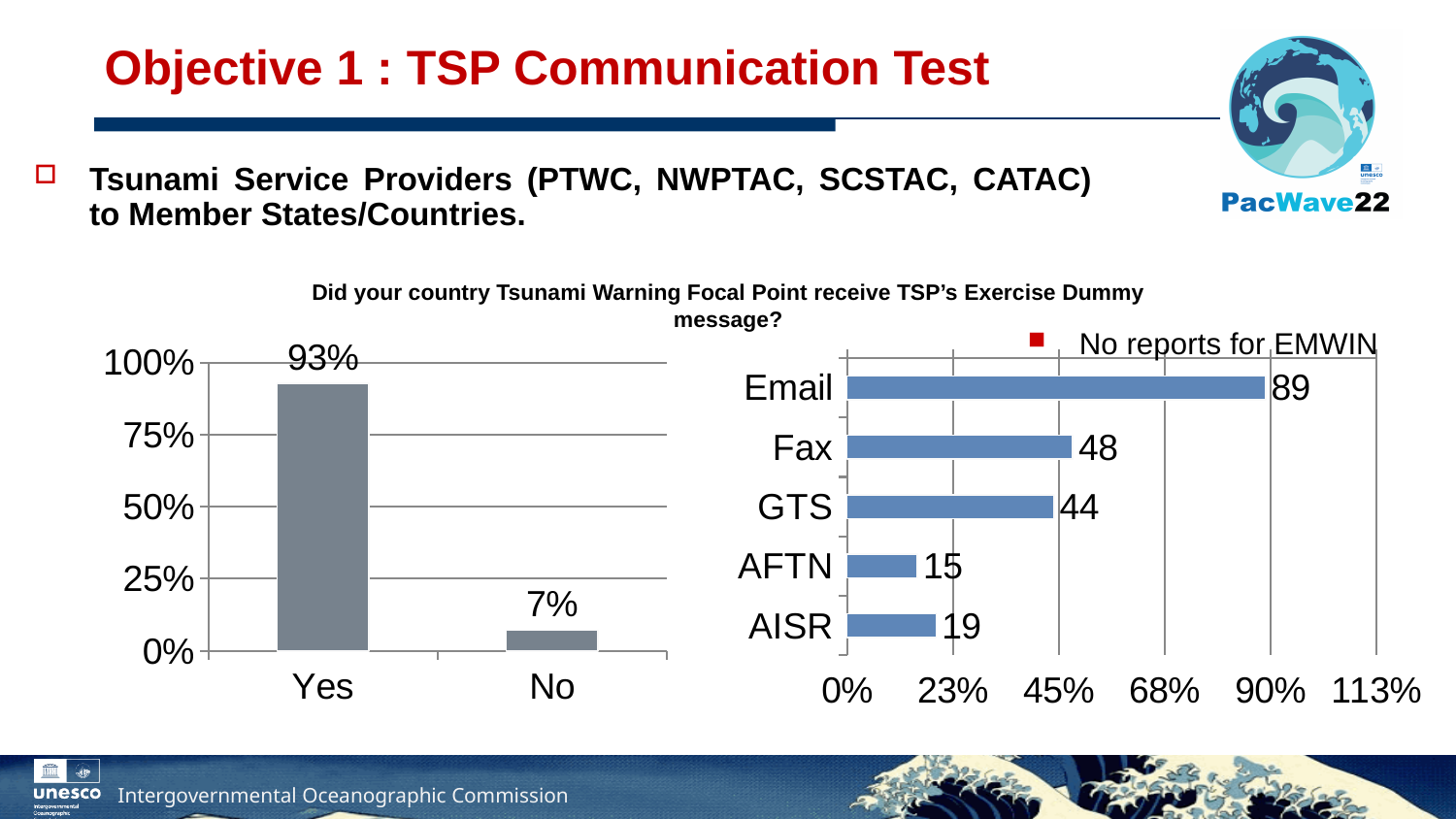
On the right chart, what is the value for Email? 89 On the left chart, what is the value for No? 7% What kind of chart is the right chart? Bar chart On the right chart, what is the value for GTS? 44 On the right chart, which is larger, the value for Fax or the value for GTS? Fax On the right chart, what is the difference between the Email and Fax values? 41 On the left chart, what is the difference between the Yes and No values? 86% On the right chart, which category has the lowest value? AFTN On the left chart, what is the value for Yes? 93% On the left chart, how many categories are shown on the x axis? 2 On the right chart, what is the value for AFTN? 15 On the right chart, which category has the highest value? Email